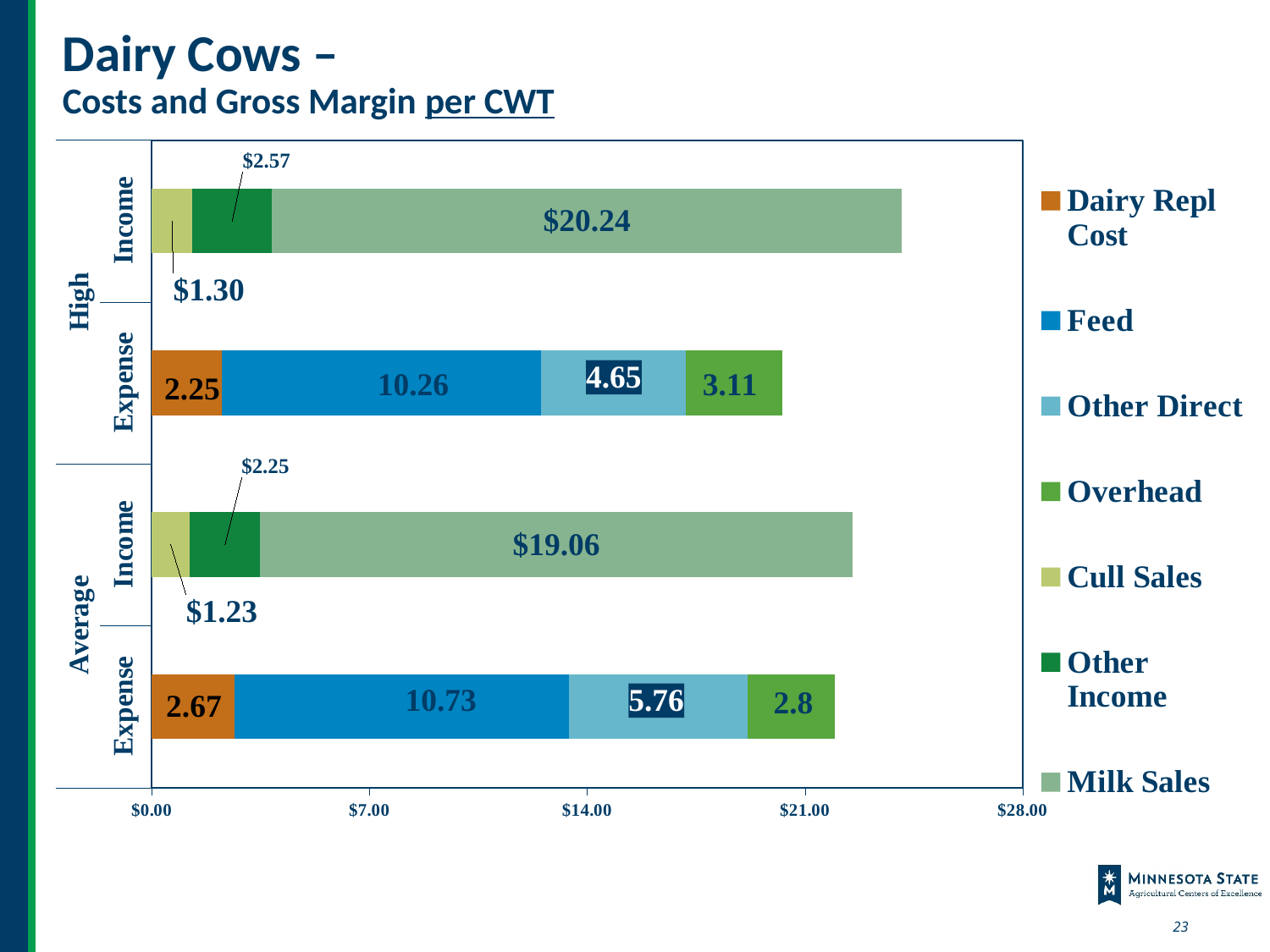
What type of chart is shown on the slide? Stacked bar chart How many series does the legend list? 7 Which is larger, the Overhead value for High Expense or for Average Expense? High Expense What is the difference between the Milk Sales values for High Income and Average Income? $1.18 What is the total of the High Expense stacked bar? 20.27 Which segment is the largest in the Average Expense bar? Feed What is the Milk Sales value for the High Income bar? $20.24 What is the Other Direct value for the High Expense bar? 4.65 What is the total of the Average Income stacked bar? $22.54 How many stacked bars are plotted on the chart? 4 What is the Cull Sales value for the Average Income bar? $1.23 What is the Feed value for the Average Expense bar? 10.73